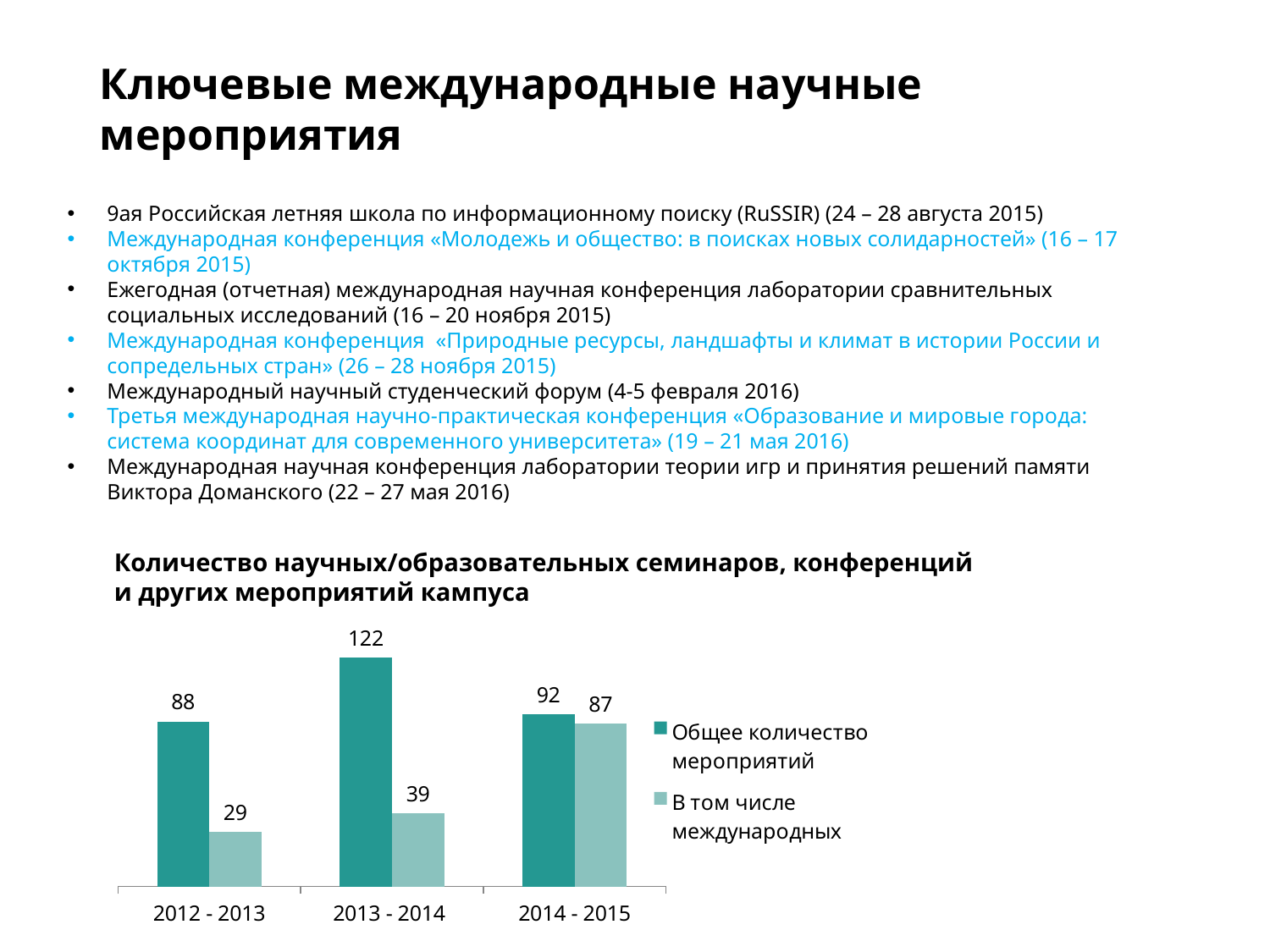
Which period has the highest value for "Общее количество мероприятий"? 2013 - 2014 What is the value of "В том числе международных" for 2012 - 2013? 29 What is the difference between "Общее количество мероприятий" in 2013 - 2014 and in 2012 - 2013? 34 Which is larger: "В том числе международных" in 2013 - 2014 or in 2014 - 2015? 2014 - 2015 How many series does the chart legend list? 2 What is the value of "Общее количество мероприятий" for 2013 - 2014? 122 What is the difference between "Общее количество мероприятий" and "В том числе международных" in 2014 - 2015? 5 Does the value of "В том числе международных" rise or fall from 2012 - 2013 to 2014 - 2015? Rise Which period has the lowest value for "В том числе международных"? 2012 - 2013 What kind of chart is shown on the slide? Bar chart What is the value of "В том числе международных" for 2014 - 2015? 87 How many periods are shown on the x axis of the chart? 3